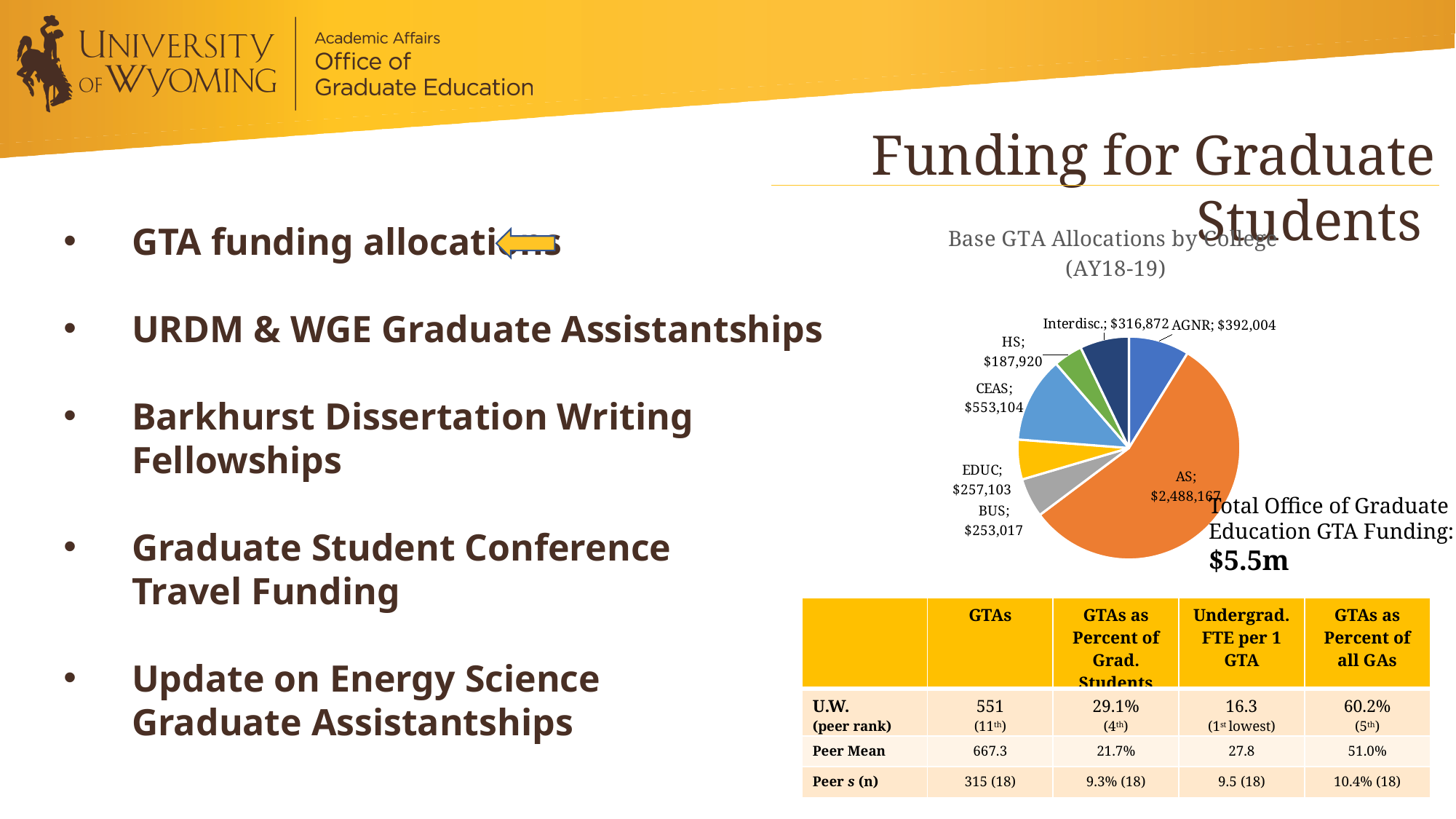
What is the difference between the AS and CEAS base GTA allocations? $1,935,063 What is the base GTA allocation for AS in the pie chart? $2,488,167 Which has a larger base GTA allocation, AGNR or Interdisc.? AGNR Which college has the largest base GTA allocation in the pie chart? AS Which college has the smallest base GTA allocation in the pie chart? HS What is the base GTA allocation for HS in the pie chart? $187,920 What is the title of the pie chart? Base GTA Allocations by College (AY18-19) How many colleges/slices are shown in the pie chart? 7 What is the base GTA allocation for CEAS in the pie chart? $553,104 What kind of chart is used to show the base GTA allocations by college? Pie chart What is the difference between the AGNR and Interdisc. base GTA allocations? $75,132 What is the base GTA allocation for Interdisc. in the pie chart? $316,872